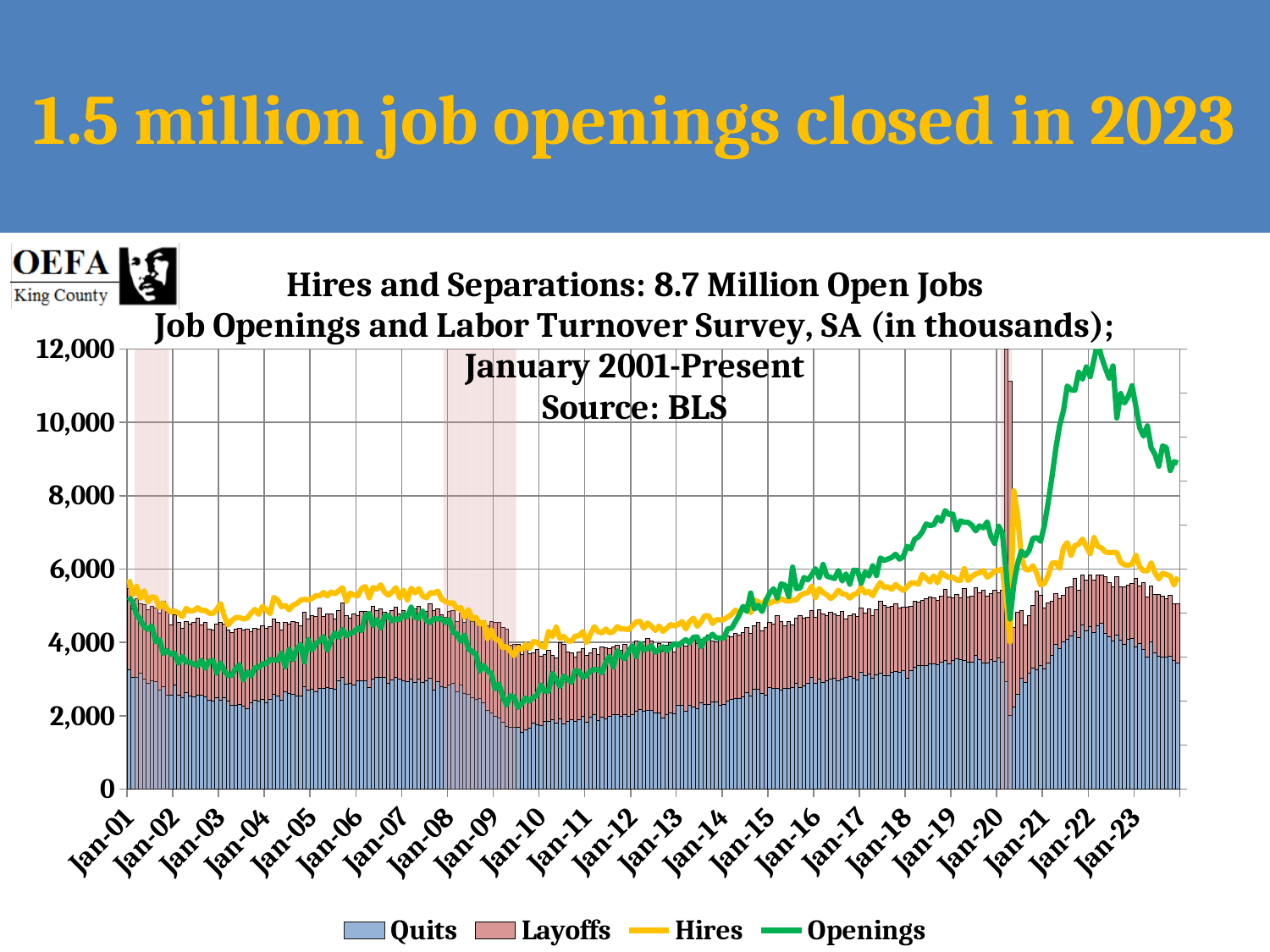
What kind of chart is this? A combined stacked bar and line chart At Jan-10, which is higher: Openings or Hires? Hires Which series are shown as stacked bars? Quits and Layoffs Do Openings rise or fall between Jan-10 and Jan-19? rise Do Openings rise or fall between Jan-22 and Jan-23? fall Is the value of Openings at Jan-22 greater or less than 10,000? greater Is the value of Openings at Jan-10 greater or less than 4,000? less At Jan-22, which is higher: Openings or Hires? Openings What is the source cited in the chart title? BLS Is the value of Quits at Jan-10 greater or less than 2,000? less How many series does the legend list? 4